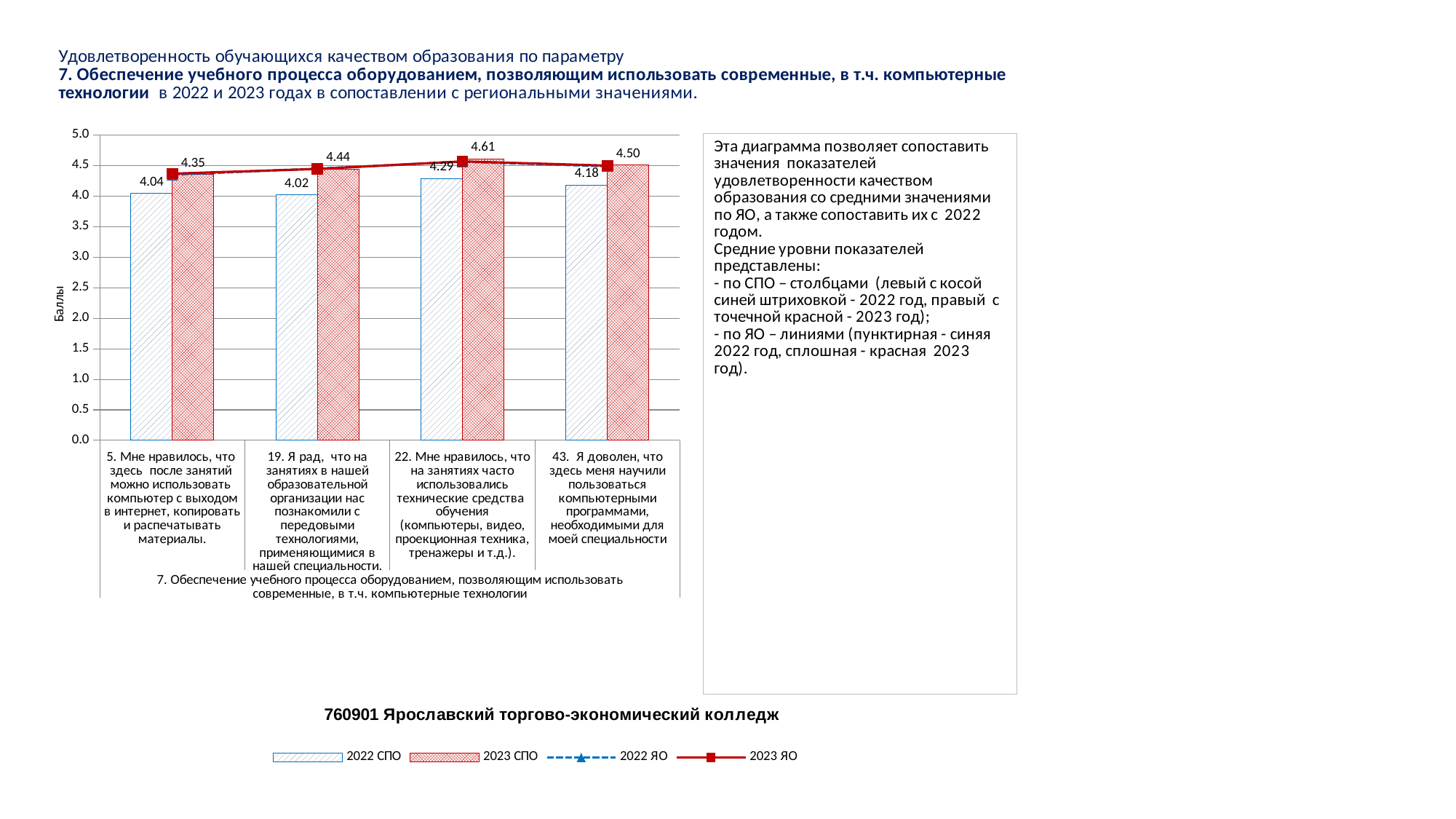
What is the label of the vertical axis of the chart? Баллы What is the 2022 СПО value for category 5 ("Мне нравилось, что здесь после занятий можно использовать компьютер...")? 4.04 How many series does the chart legend list? 4 What is the difference between the 2022 СПО values for category 22 and category 5? 0.25 Is the 2022 СПО value for category 22 greater or less than 4.0? greater Which is larger: the 2022 СПО value for category 43 or for category 19? Category 43 (4.18) How many categories are shown on the x axis of the chart? 4 What is the 2022 СПО value for category 43 ("Я доволен, что здесь меня научили пользоваться компьютерными программами...")? 4.18 What is the 2022 СПО value for category 22 ("Мне нравилось, что на занятиях часто использовались технические средства обучения...")? 4.29 What is the 2023 СПО value for category 19 ("Я рад, что на занятиях в нашей образовательной организации нас познакомили с передовыми технологиями...")? 4.44 Which category has the lowest 2022 СПО value? 19. Я рад, что на занятиях в нашей образовательной организации нас познакомили с передовыми технологиями Which category has the highest 2022 СПО value? 22. Мне нравилось, что на занятиях часто использовались технические средства обучения